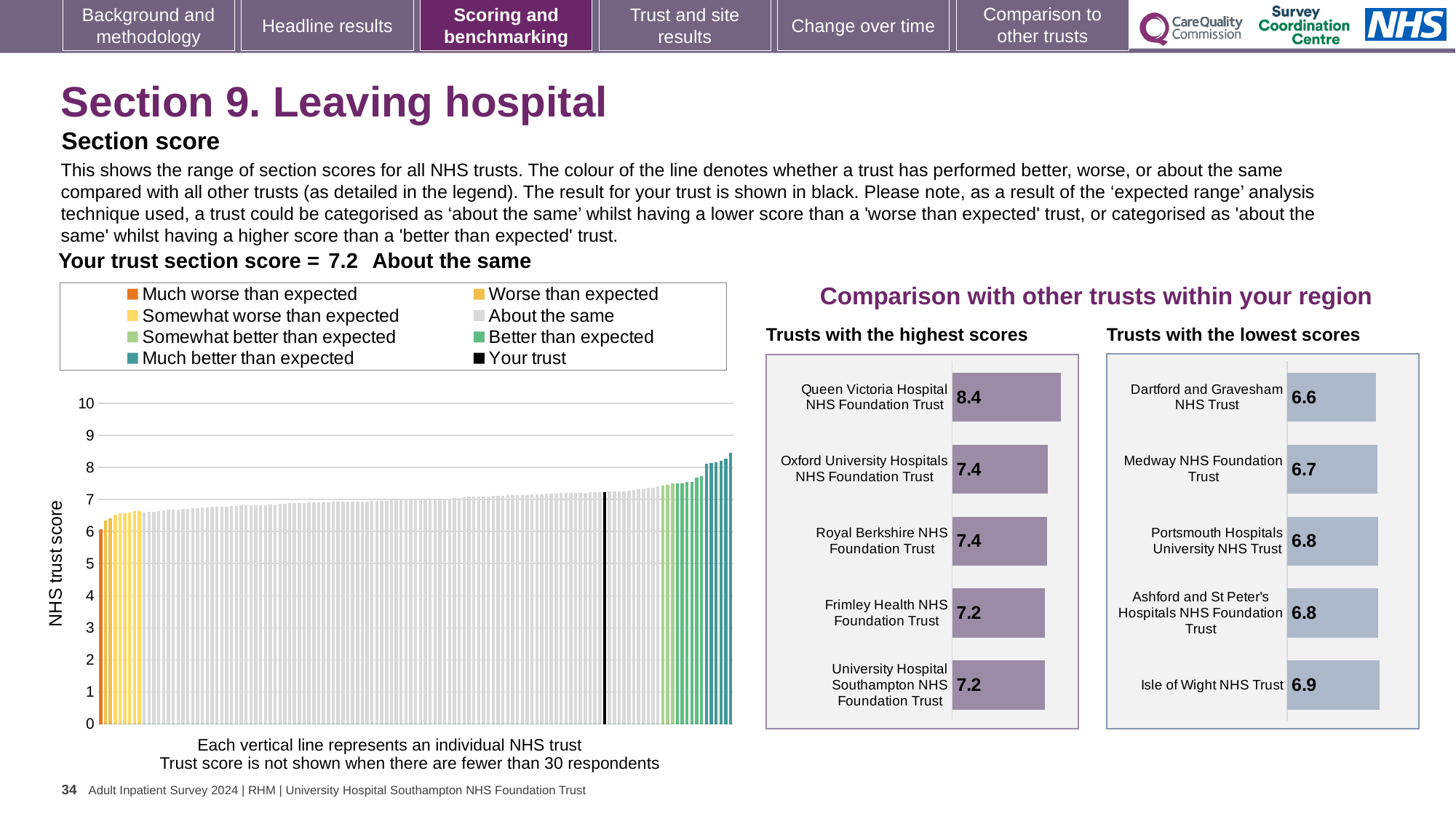
In the 'Trusts with the lowest scores' chart, which has the larger score: Isle of Wight NHS Trust or Dartford and Gravesham NHS Trust? Isle of Wight NHS Trust In the 'Trusts with the lowest scores' chart, which trust has the lowest score? Dartford and Gravesham NHS Trust How many trusts are shown in the 'Trusts with the highest scores' chart? 5 How many entries does the legend of the main NHS trust score chart list? 8 In the 'Trusts with the highest scores' chart, which trust has the highest score? Queen Victoria Hospital NHS Foundation Trust In the 'Trusts with the highest scores' chart, what is the score for Queen Victoria Hospital NHS Foundation Trust? 8.4 What kind of chart is the main chart showing NHS trust scores on the left of the slide? bar chart In the 'Trusts with the lowest scores' chart, what is the score for Medway NHS Foundation Trust? 6.7 In the 'Trusts with the highest scores' chart, what is the difference between the scores of Queen Victoria Hospital NHS Foundation Trust and Frimley Health NHS Foundation Trust? 1.2 In the 'Trusts with the lowest scores' chart, what is the difference between the scores of Isle of Wight NHS Trust and Dartford and Gravesham NHS Trust? 0.3 What is your trust's section score for Section 9, Leaving hospital? 7.2 In the main NHS trust score chart, is the value of the tallest bar greater or less than 8? greater